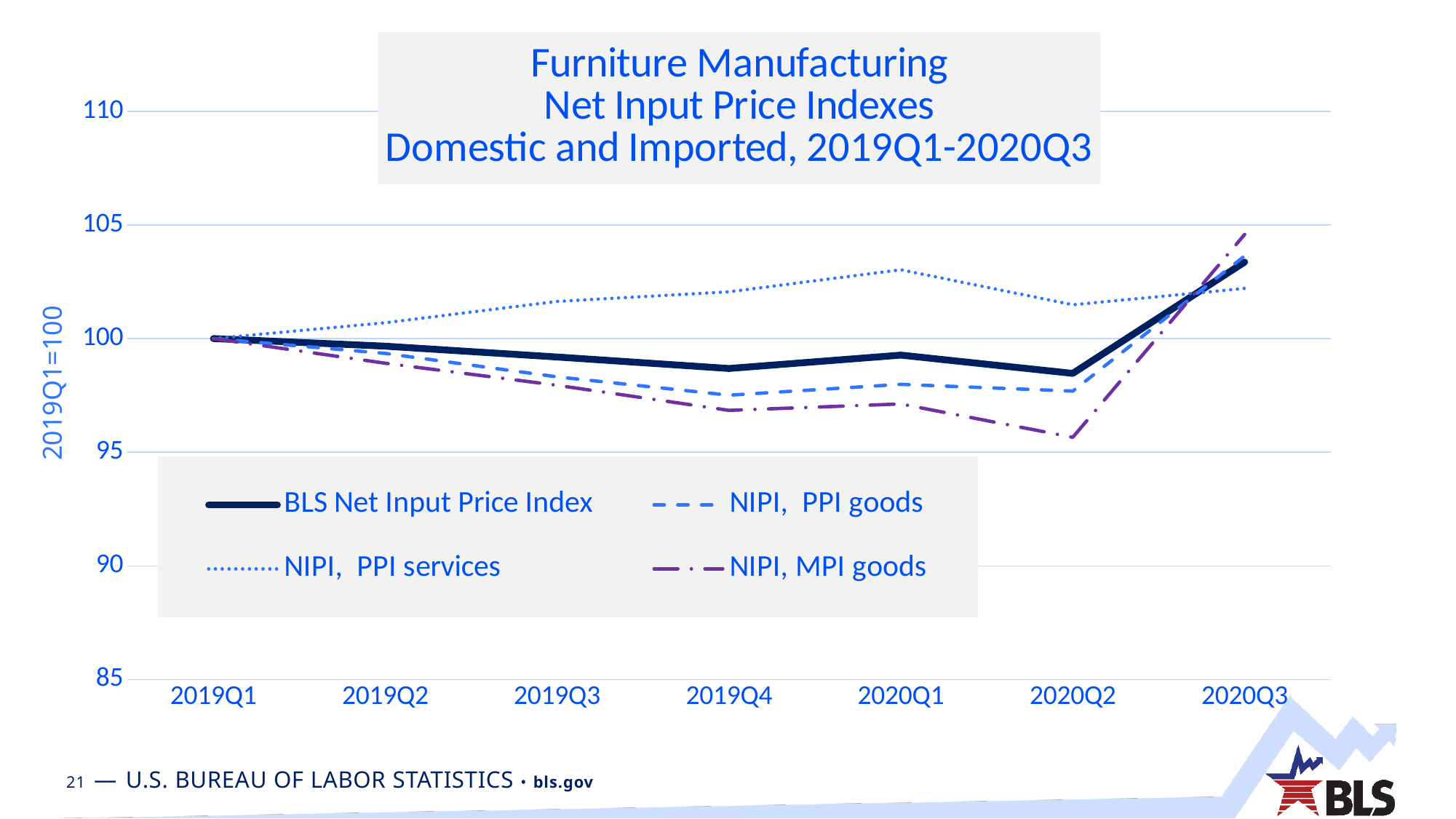
Which series has the lowest value in 2020Q2? NIPI, MPI goods Does the BLS Net Input Price Index rise or fall from 2020Q2 to 2020Q3? rise How many quarters are plotted along the x axis? 7 What kind of chart is shown on the slide? line chart Which series has the highest value in 2020Q1? NIPI, PPI services Is the value for NIPI, MPI goods in 2020Q2 greater or less than 100? less How many series does the legend list? 4 Is the value for NIPI, PPI services in 2020Q1 greater or less than 100? greater What is the label on the vertical axis? 2019Q1=100 Which series has the highest value in 2020Q3? NIPI, MPI goods In 2019Q4, which is larger: NIPI, PPI services or NIPI, PPI goods? NIPI, PPI services What is the value of the BLS Net Input Price Index in 2019Q1? 100